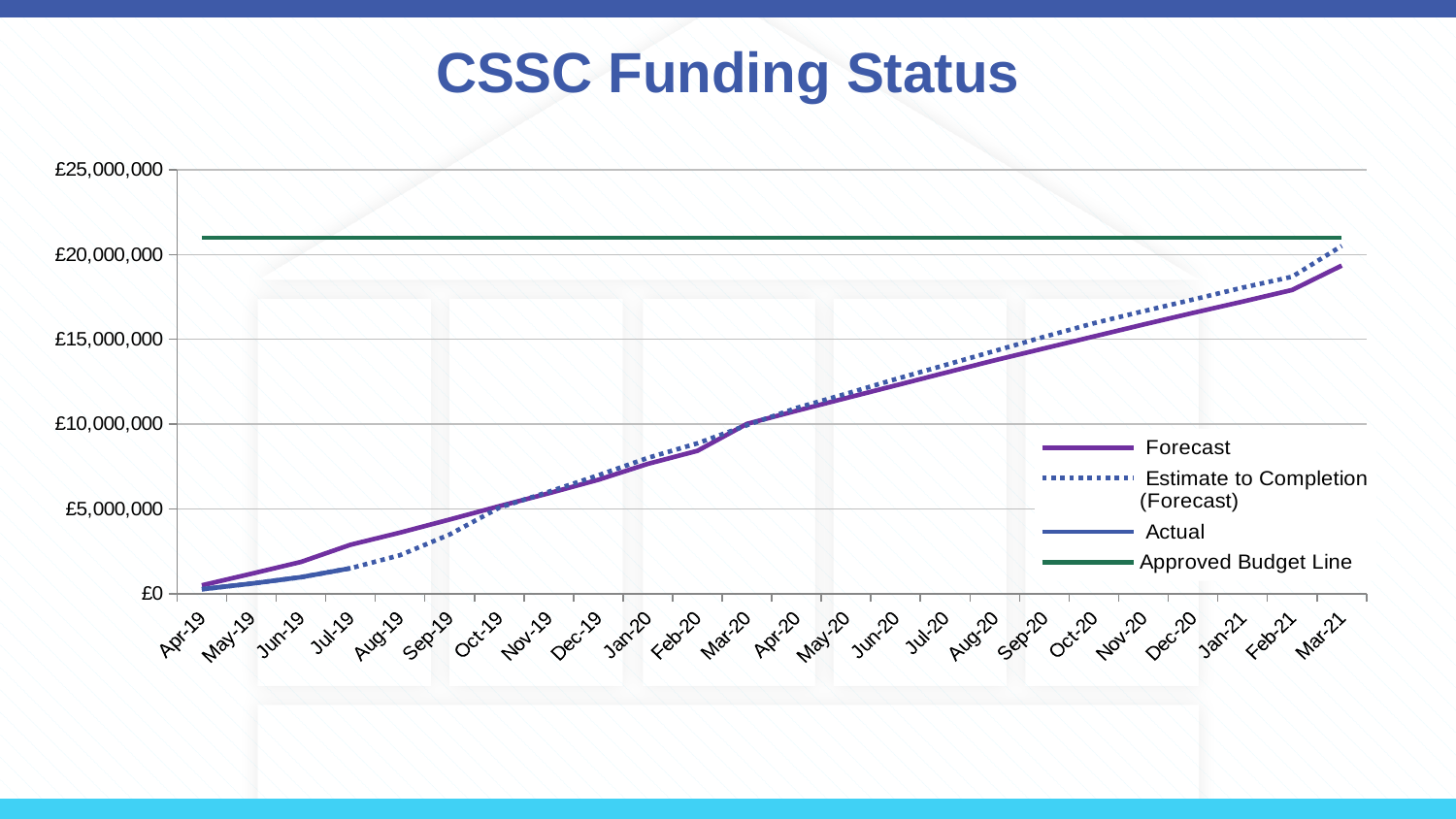
Which series is drawn as a dotted line? Estimate to Completion (Forecast) How many series does the legend list? 4 What is the title of the chart? CSSC Funding Status Is the Forecast value for Dec-20 greater or less than £15,000,000? greater How many months are shown along the x axis? 24 Is the Forecast value for Jul-19 greater or less than £5,000,000? less At Mar-21, which is higher: the Forecast or the Estimate to Completion (Forecast)? Estimate to Completion (Forecast) Is the Forecast value for Mar-21 greater or less than £20,000,000? less What kind of chart is shown on the slide? Line chart Does the Forecast series rise or fall from Apr-19 to Mar-21? Rises At Jul-19, which is higher: the Forecast or the Actual? Forecast